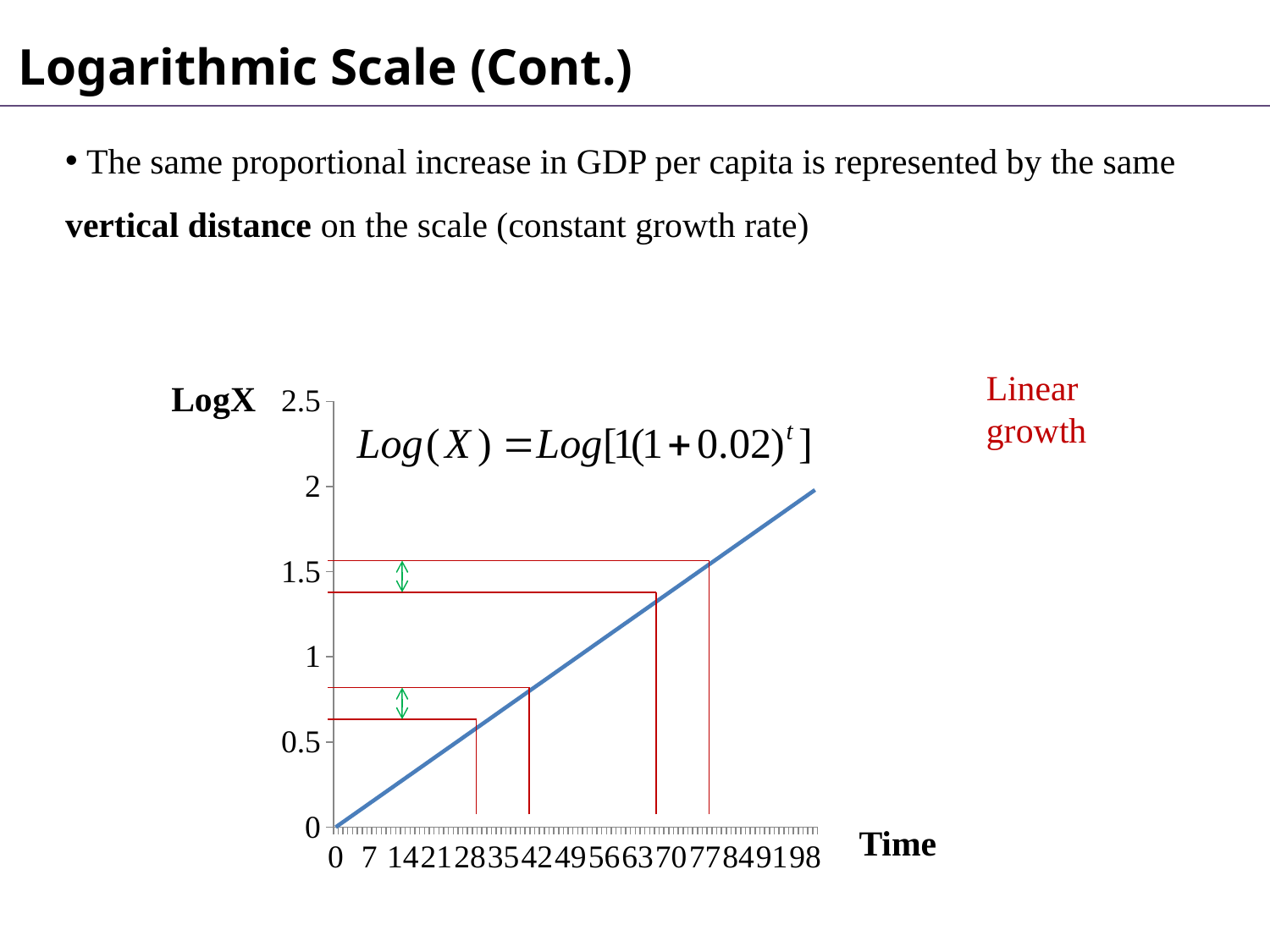
What is the label of the vertical axis? LogX Does the plotted line rise or fall as Time increases? rises What is the highest tick value shown on the vertical axis? 2.5 What is the label of the horizontal axis? Time Is the value of LogX at Time 84 greater or less than 1.5? greater Is the value of LogX at Time 70 greater or less than 1? greater How many tick labels are shown on the horizontal Time axis? 15 How many data series are plotted on the chart? 1 What kind of chart is shown on the slide? line chart Is the value of LogX at Time 14 greater or less than 0.5? less What is the largest Time value labelled on the horizontal axis? 98